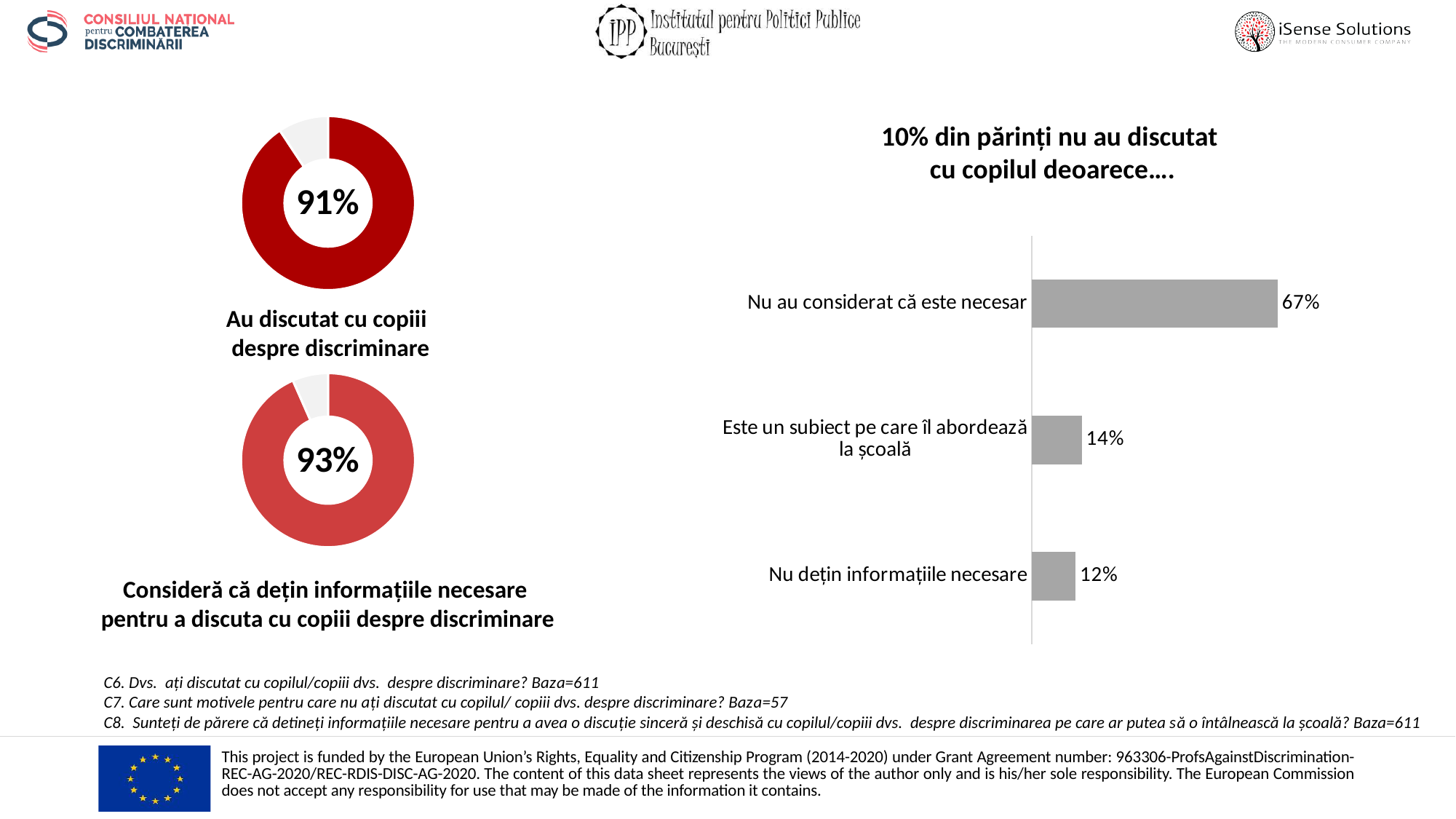
In the top donut chart on the left, "Au discutat cu copiii despre discriminare", what percentage is shown? 91% What is the title of the bar chart on the right side of the slide? 10% din părinți nu au discutat cu copilul deoarece…. In the bar chart on the right, which category has the lowest value? Nu dețin informațiile necesare In the bar chart on the right, how many categories are shown? 3 What kind of chart is the chart on the right side of the slide? Bar chart In the bottom donut chart on the left, "Consideră că dețin informațiile necesare pentru a discuta cu copiii despre discriminare", what percentage is shown? 93% In the bar chart on the right, which category has the highest value? Nu au considerat că este necesar In the bar chart on the right, what is the difference between "Nu au considerat că este necesar" and "Este un subiect pe care îl abordează la școală"? 53% In the bar chart titled "10% din părinți nu au discutat cu copilul deoarece….", what is the value for "Nu au considerat că este necesar"? 67% In the bar chart titled "10% din părinți nu au discutat cu copilul deoarece….", what is the value for "Nu dețin informațiile necesare"? 12% In the bar chart titled "10% din părinți nu au discutat cu copilul deoarece….", what is the value for "Este un subiect pe care îl abordează la școală"? 14% Which of the two donut charts on the left shows the larger percentage: "Au discutat cu copiii despre discriminare" or "Consideră că dețin informațiile necesare pentru a discuta cu copiii despre discriminare"? Consideră că dețin informațiile necesare pentru a discuta cu copiii despre discriminare